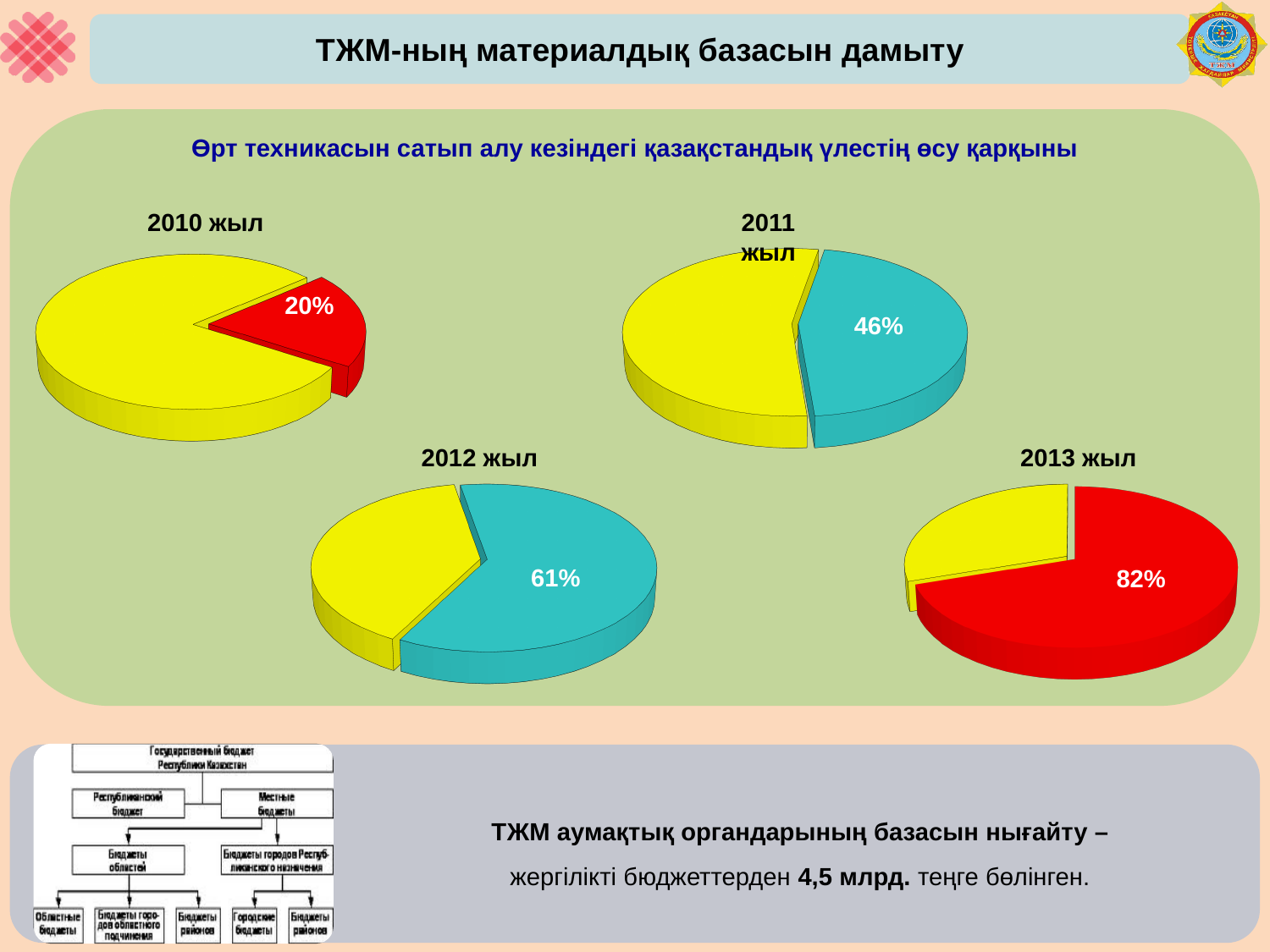
Across the four pie charts, which year has the highest labelled share? 2013 жыл In the 2010 жыл pie chart, what percentage is shown on the labelled slice? 20% In the 2013 жыл pie chart, what percentage is shown on the labelled slice? 82% What is the difference between the labelled share in the 2012 жыл chart and the labelled share in the 2011 жыл chart? 15% What is the difference between the labelled share in the 2013 жыл chart and the labelled share in the 2010 жыл chart? 62% In the 2012 жыл pie chart, what percentage is shown on the labelled slice? 61% Do the labelled shares rise or fall from 2010 жыл to 2013 жыл? Rise Which is larger: the labelled share in the 2011 жыл chart or the labelled share in the 2012 жыл chart? 2012 жыл How many slices does the 2010 жыл pie chart have? 2 What kind of chart is used for each year on this slide? Pie chart In the 2011 жыл pie chart, what percentage is shown on the labelled slice? 46% Across the four pie charts, which year has the lowest labelled share? 2010 жыл